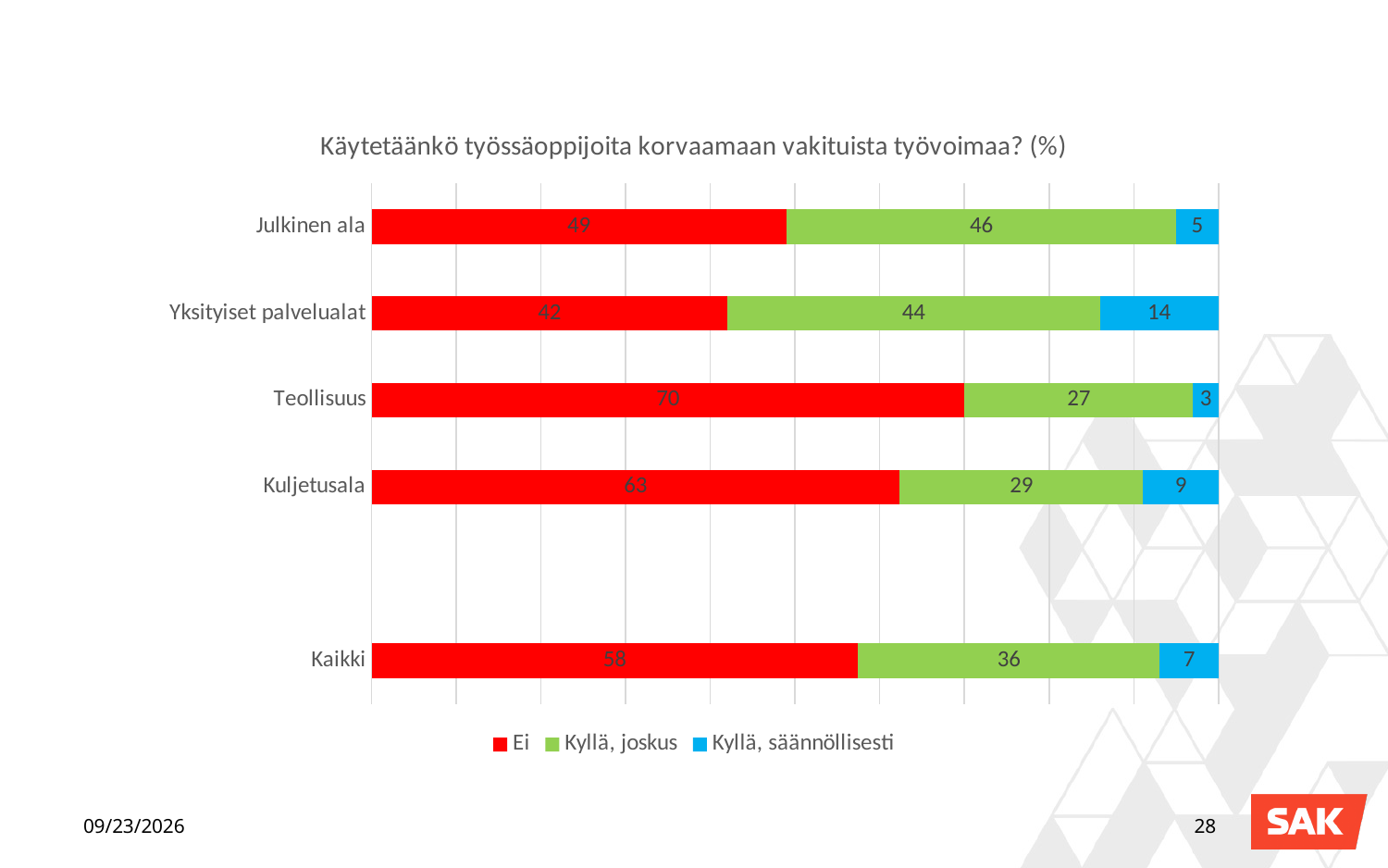
How many categories are shown on the chart? 5 Which is larger: the "Kyllä, joskus" value for Julkinen ala or for Kuljetusala? Julkinen ala What is the difference between the "Ei" values for Kuljetusala and Julkinen ala? 14 How many series does the legend list? 3 Which category has the highest value for "Ei"? Teollisuus What is the value of "Kyllä, joskus" for Kaikki? 36 What kind of chart is shown on the slide? Stacked bar chart Which category has the lowest value for "Kyllä, säännöllisesti"? Teollisuus What is the value of "Ei" for Teollisuus? 70 What is the title of the chart? Käytetäänkö työssäoppijoita korvaamaan vakituista työvoimaa? (%) What is the total of the stacked bar for Kaikki? 101 What is the value of "Kyllä, säännöllisesti" for Yksityiset palvelualat? 14